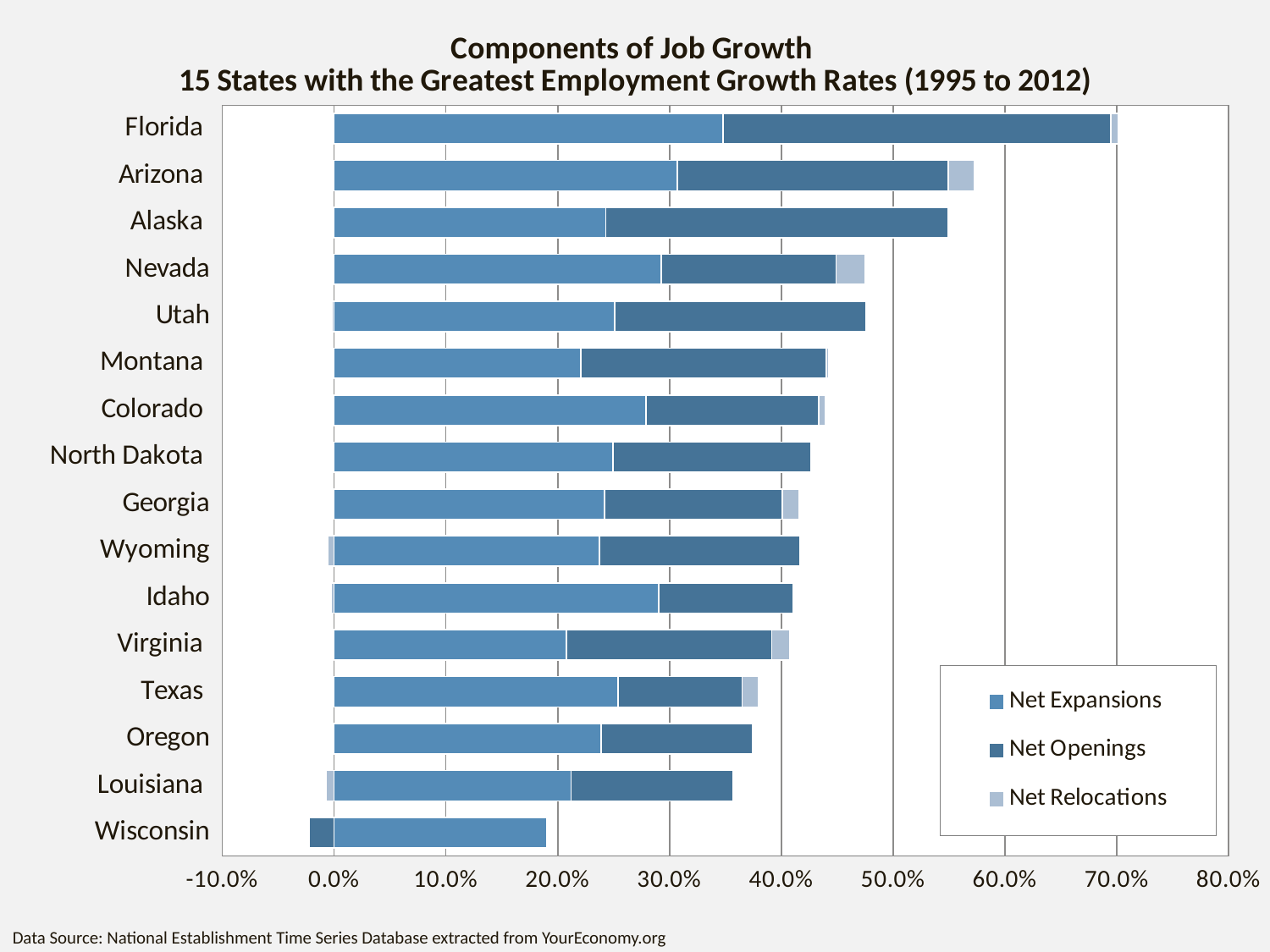
Is the total bar for Florida greater or less than 60.0%? greater Is the total bar for Oregon greater or less than 40.0%? less How many states are shown on the chart? 16 What kind of chart is shown on the slide? Stacked bar chart Which state has the larger total bar, Florida or Arizona? Florida Which state has the shortest total bar? Wisconsin Is the Net Expansions value for Wisconsin greater or less than 20.0%? less How many series does the legend list? 3 Which state has the larger total bar, Alaska or Nevada? Alaska What are the three series named in the legend? Net Expansions, Net Openings, Net Relocations Which state has the longest total bar? Florida